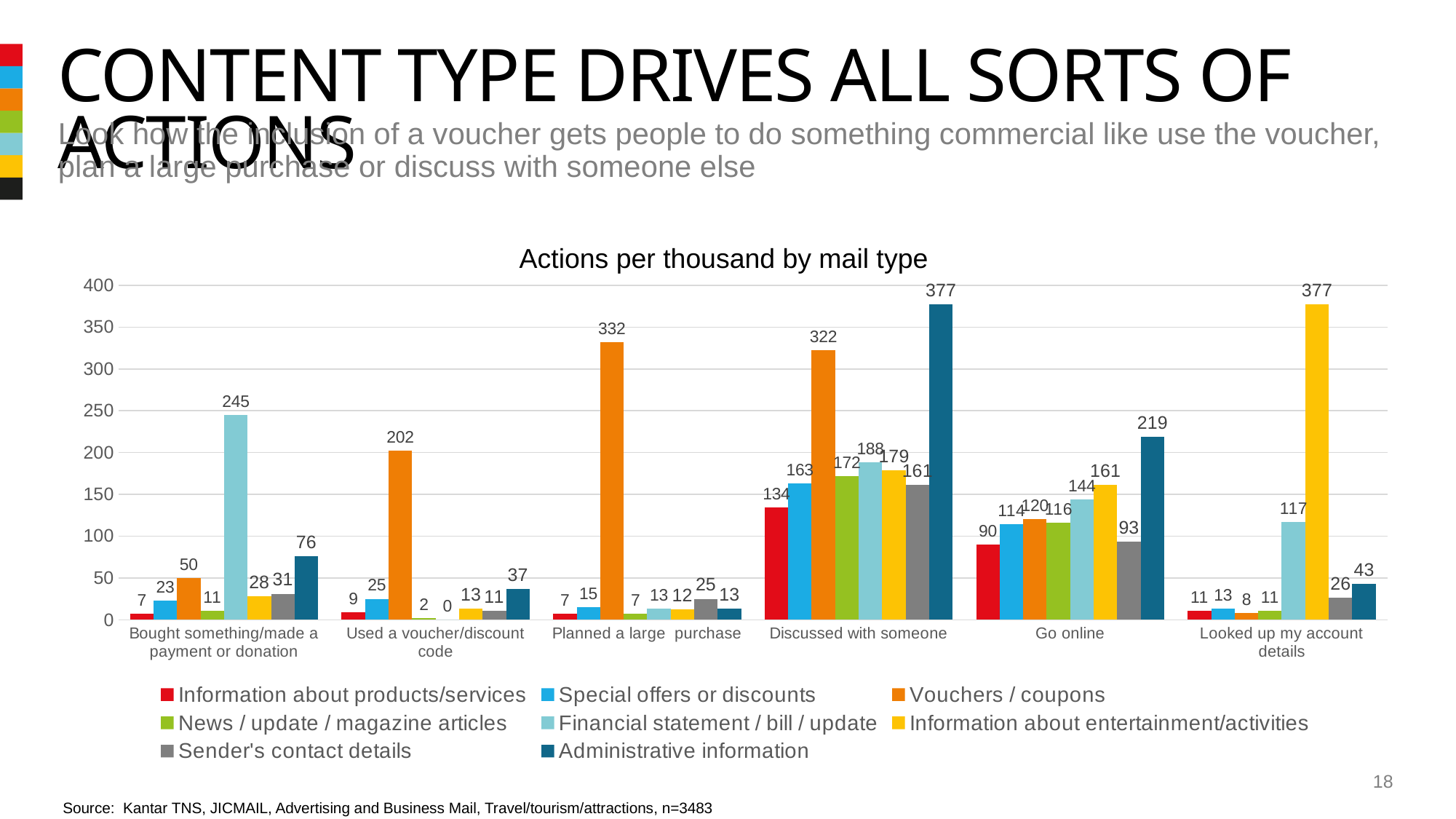
Which mail type has the highest value in the Discussed with someone category? Administrative information In the Discussed with someone category, which is larger: Vouchers / coupons or Financial statement / bill / update? Vouchers / coupons How many action categories are shown on the x axis? 6 What is the title of the chart? Actions per thousand by mail type What is the value for Financial statement / bill / update in the Bought something/made a payment or donation category? 245 Which mail type has the lowest value in the Used a voucher/discount code category? Financial statement / bill / update How many mail types does the legend list? 8 What is the difference between Administrative information and Information about products/services in the Go online category? 129 What is the value for Vouchers / coupons in the Planned a large purchase category? 332 What kind of chart is shown on the slide? Bar chart What is the value for Information about entertainment/activities in the Looked up my account details category? 377 What is the value for Administrative information in the Go online category? 219